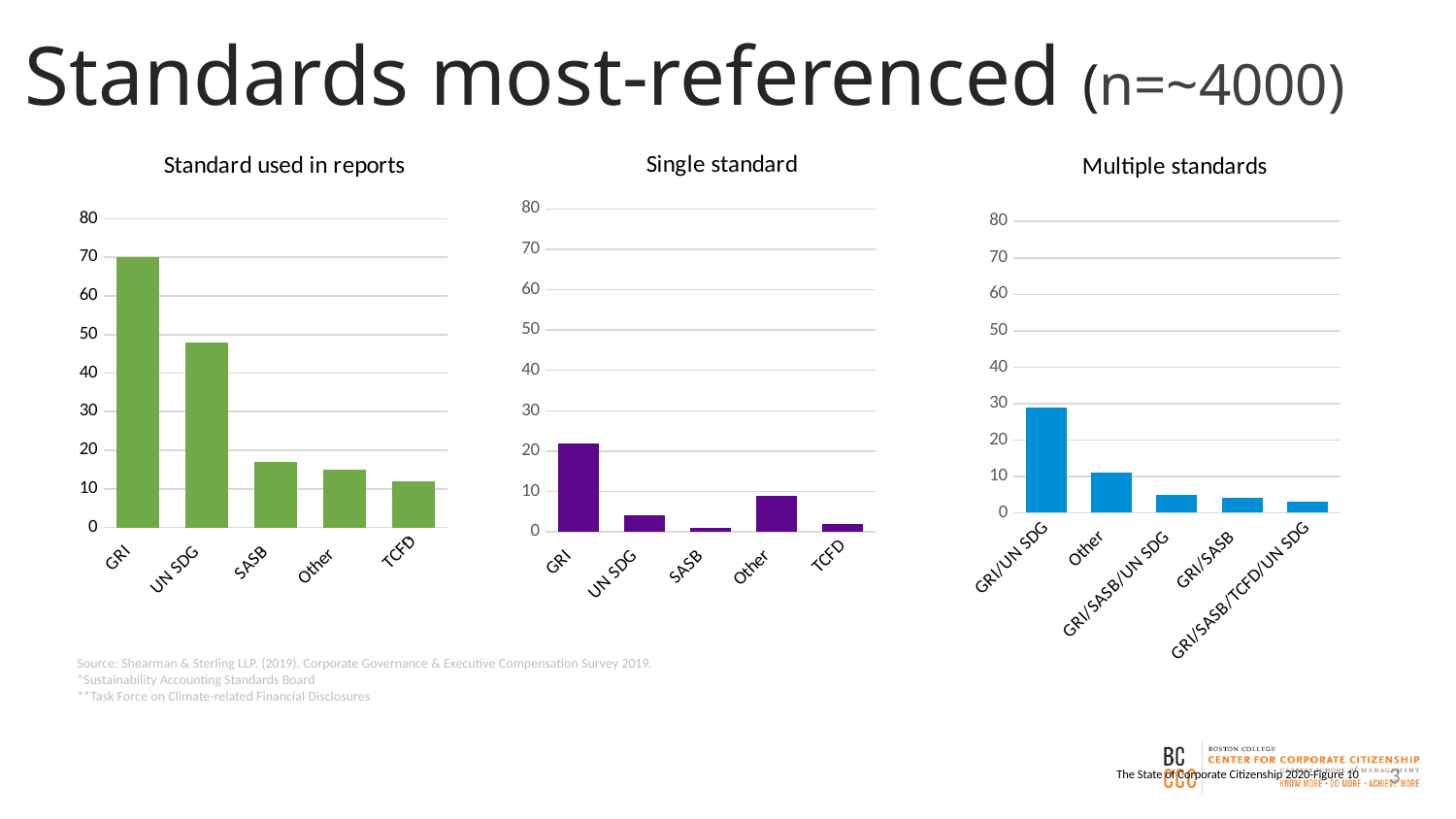
In the 'Standard used in reports' chart, which category has the highest value? GRI In the 'Single standard' chart, is the value for GRI greater or less than 20? greater What kind of chart is the 'Multiple standards' chart? Bar chart In the 'Standard used in reports' chart, is the value for UN SDG greater or less than 40? greater In the 'Single standard' chart, which category has the lowest value? SASB In the 'Standard used in reports' chart, which category has the lowest value? TCFD In the 'Standard used in reports' chart, how many categories are shown on the x axis? 5 How many charts are shown on the slide? 3 In the 'Multiple standards' chart, is the value for GRI/UN SDG greater or less than 20? greater In the 'Single standard' chart, which category has the highest value? GRI In the 'Single standard' chart, which is larger, the value for Other or the value for UN SDG? Other In the 'Multiple standards' chart, which category has the highest value? GRI/UN SDG